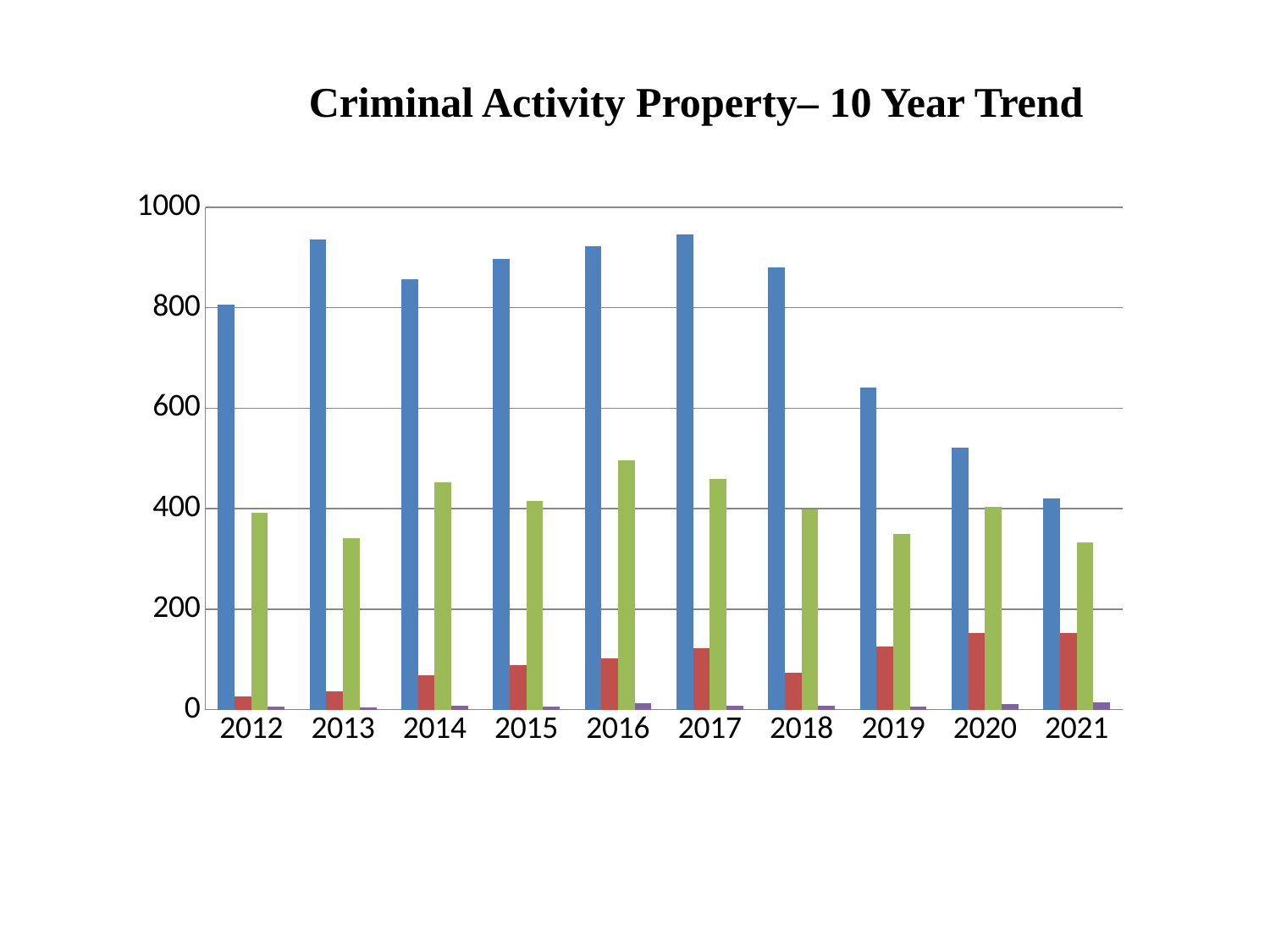
Do the blue bars rise or fall from 2018 to 2021? fall Is the value of the green bar for 2013 greater or less than 400? less How many years are shown on the x axis of the chart? 10 Which is larger, the blue bar for 2019 or the blue bar for 2020? 2019 What kind of chart is shown on the slide? bar chart Is the value of the blue bar for 2019 greater or less than 600? greater In which year is the green bar the highest? 2016 In which year is the blue bar the lowest? 2021 Is the value of the red bar for 2017 greater or less than 200? less What is the title of the chart? Criminal Activity Property– 10 Year Trend In which year is the red bar the lowest? 2012